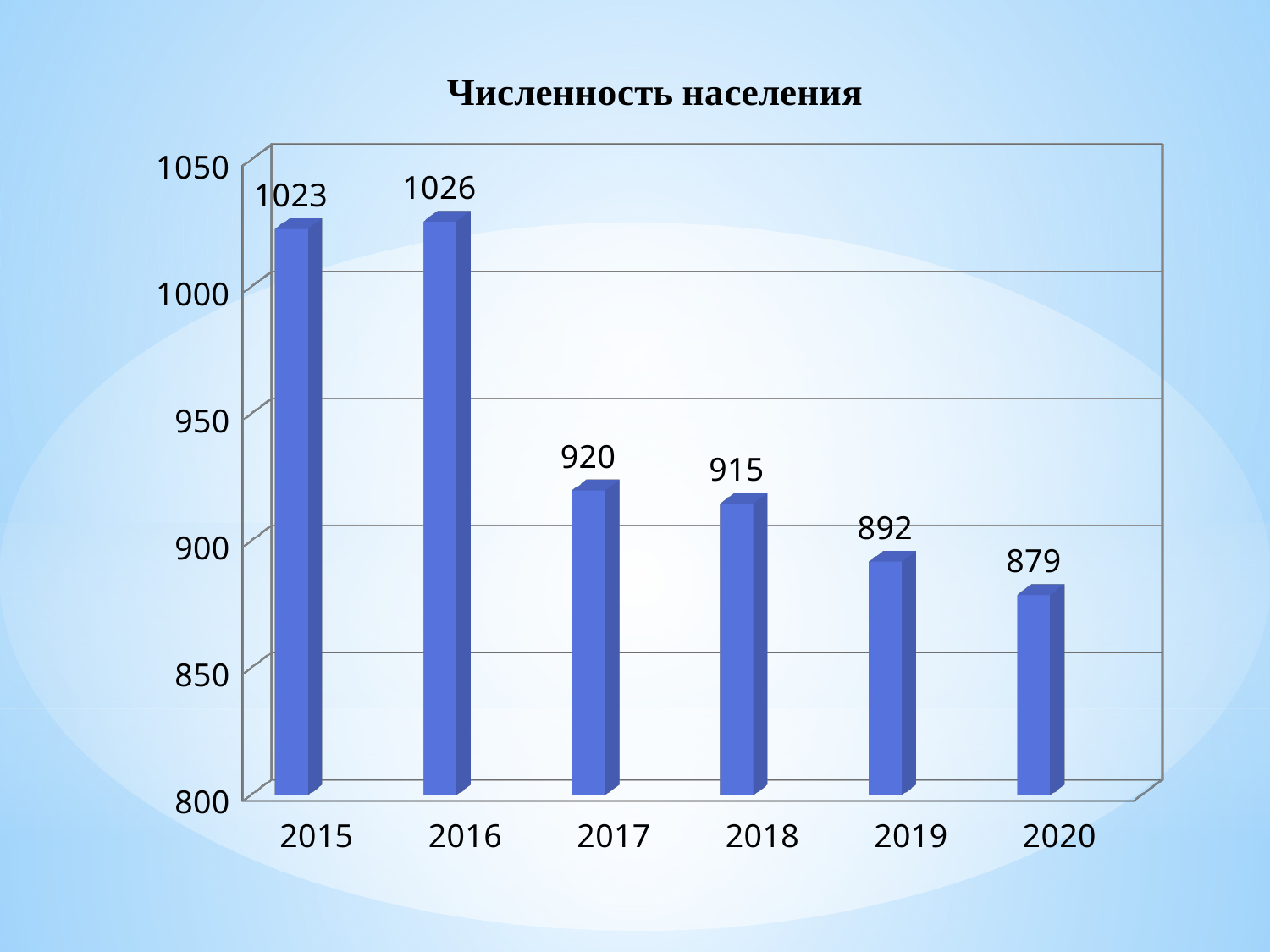
What is the population value shown for 2020? 879 What kind of chart is shown on the slide? bar chart Is the value for 2019 greater or less than 900? less Which year has the highest population value? 2016 What is the population value shown for 2017? 920 What is the population value shown for 2019? 892 Which year has the lowest population value? 2020 What is the title of the chart? Численность населения How many years are shown on the x axis? 6 Which is larger, the value for 2015 or the value for 2016? 2016 What is the difference between the values for 2017 and 2018? 5 What is the difference between the values for 2016 and 2020? 147